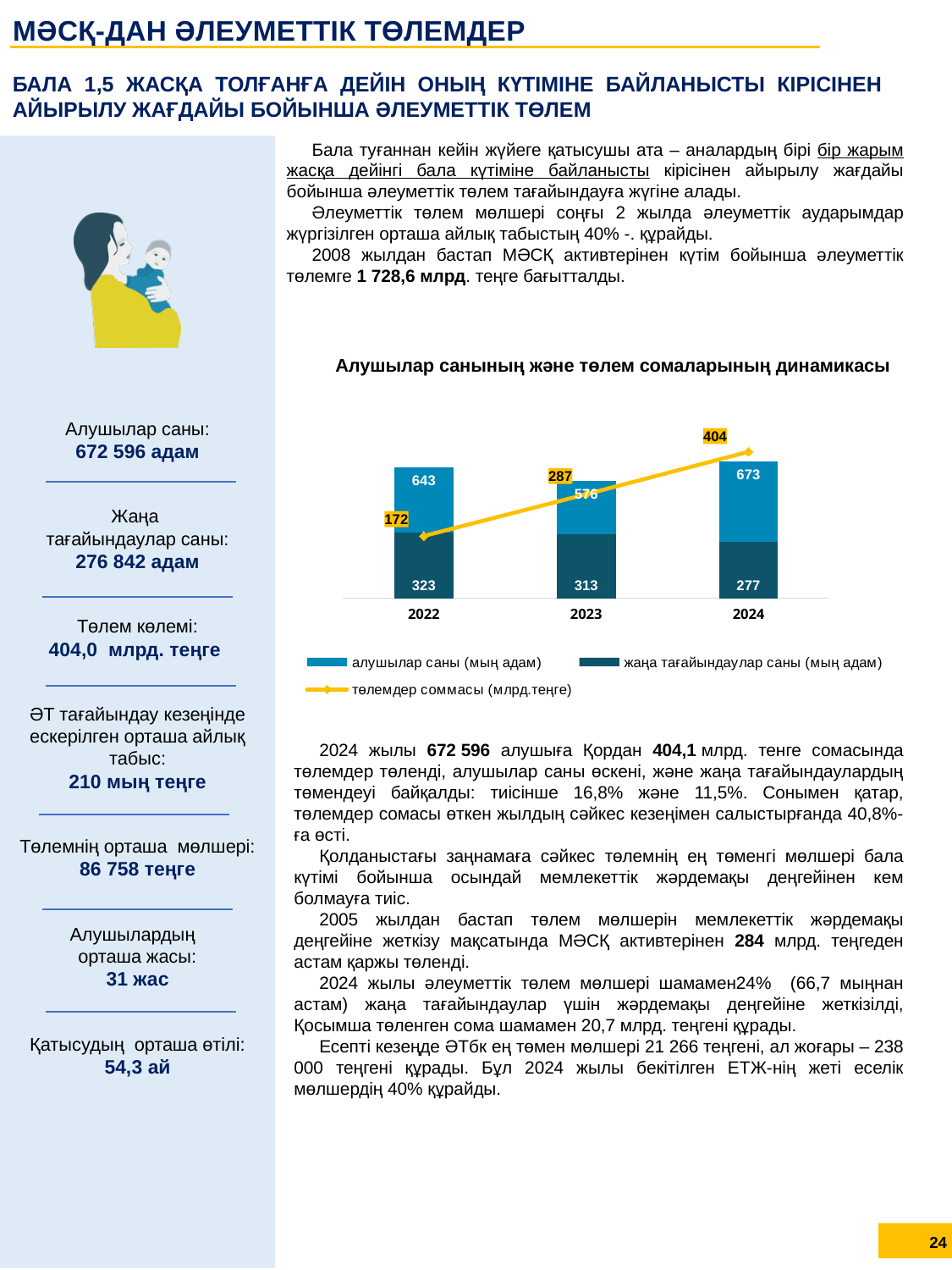
What is the value of алушылар саны (мың адам) for 2024? 673 What kind of chart is used to show алушылар саны and жаңа тағайындаулар саны? Stacked bar chart How many series does the chart legend list? 3 Does the value of төлемдер соммасы (млрд.теңге) rise or fall from 2022 to 2024? Rise What is the value of жаңа тағайындаулар саны (мың адам) for 2022? 323 What is the value of төлемдер соммасы (млрд.теңге) for 2023? 287 What is the difference between the алушылар саны (мың адам) values for 2024 and 2023? 97 How many years are shown on the x axis of the chart? 3 Which year has the highest value for төлемдер соммасы (млрд.теңге)? 2024 What is the total of the stacked bar for 2023 (алушылар саны plus жаңа тағайындаулар саны)? 889 Which year has the lowest value for алушылар саны (мың адам)? 2023 Is the value of жаңа тағайындаулар саны (мың адам) larger in 2022 or in 2024? 2022